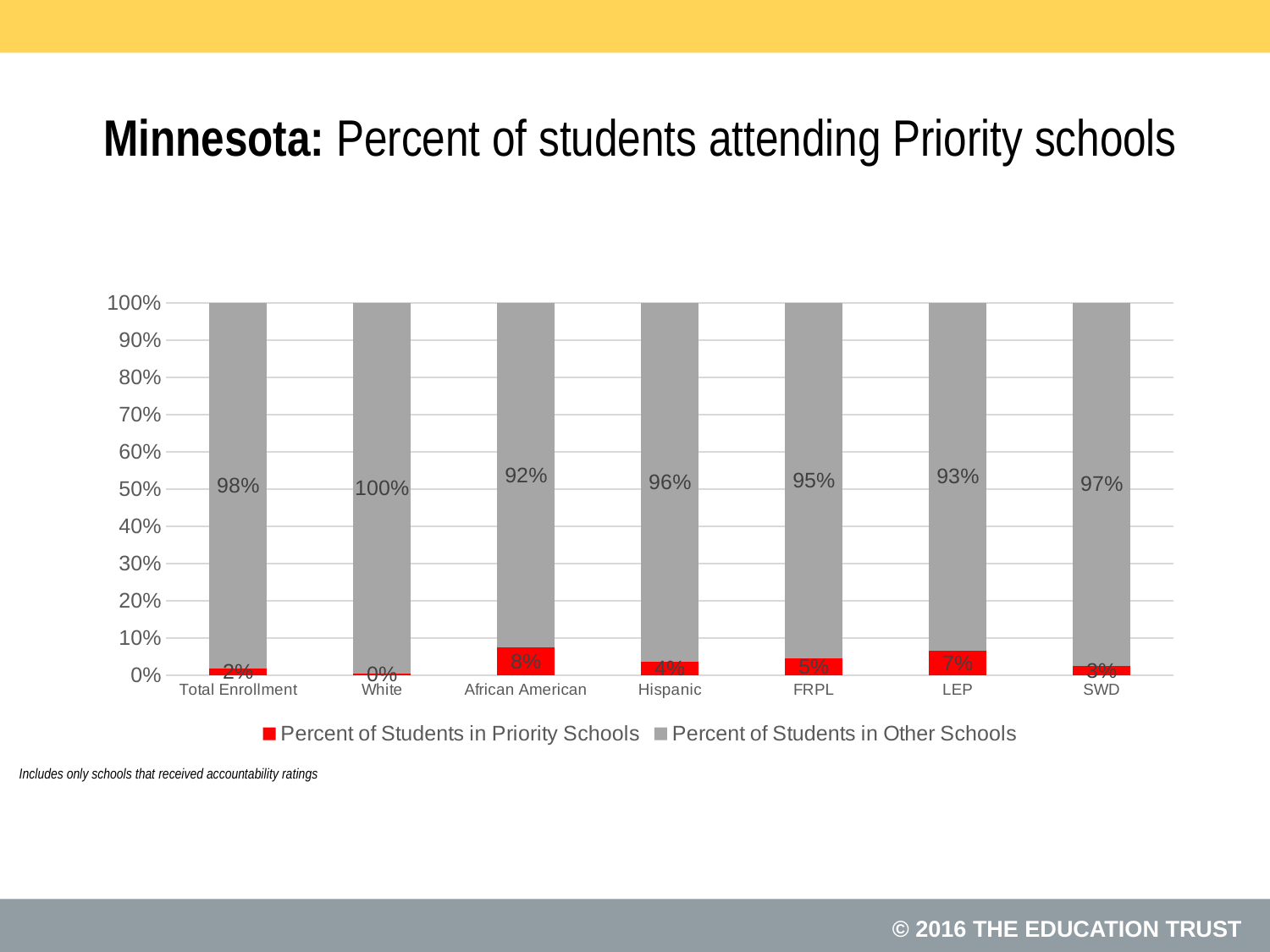
Which category has the lowest percent of students in Priority schools? White What percent of White students attend Priority schools? 0% Which colour represents Percent of Students in Priority Schools? Red Which category has the highest percent of students in Priority schools? African American What kind of chart is shown on the slide? Stacked bar chart What is the total of the stacked bar for Total Enrollment? 100% What is the difference between the percent of African American students and Hispanic students in Priority schools? 4% How many series does the legend list? 2 What percent of African American students attend Priority schools? 8% What percent of LEP students attend Other Schools? 93% How many categories are shown on the x axis? 7 Which is larger: the percent of FRPL students or SWD students in Priority schools? FRPL